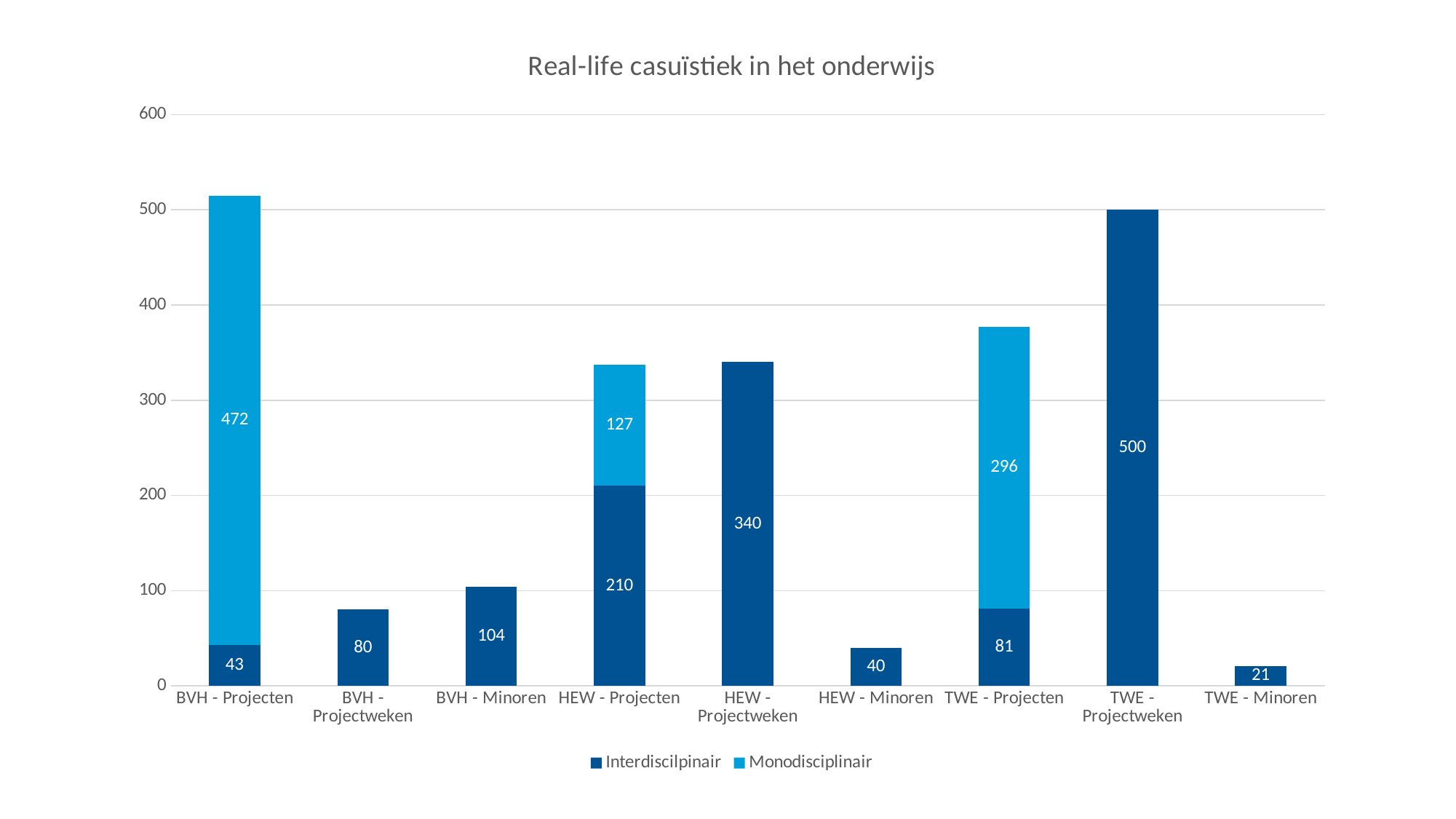
What is the difference between the Interdisciplinair values for HEW - Projecten and TWE - Projecten? 129 What is the total of the stacked bar for HEW - Projecten? 337 How many series does the legend list? 2 Which is larger, the Monodisciplinair value for BVH - Projecten or for TWE - Projecten? BVH - Projecten What type of chart is shown? Stacked bar chart What is the Interdisciplinair value for BVH - Minoren? 104 What is the Interdisciplinair value for HEW - Projectweken? 340 Which category has the lowest Interdisciplinair value? TWE - Minoren What is the total of the stacked bar for BVH - Projecten? 515 How many categories are shown on the x axis? 9 What is the Monodisciplinair value for TWE - Projecten? 296 Which category has the highest Interdisciplinair value? TWE - Projectweken